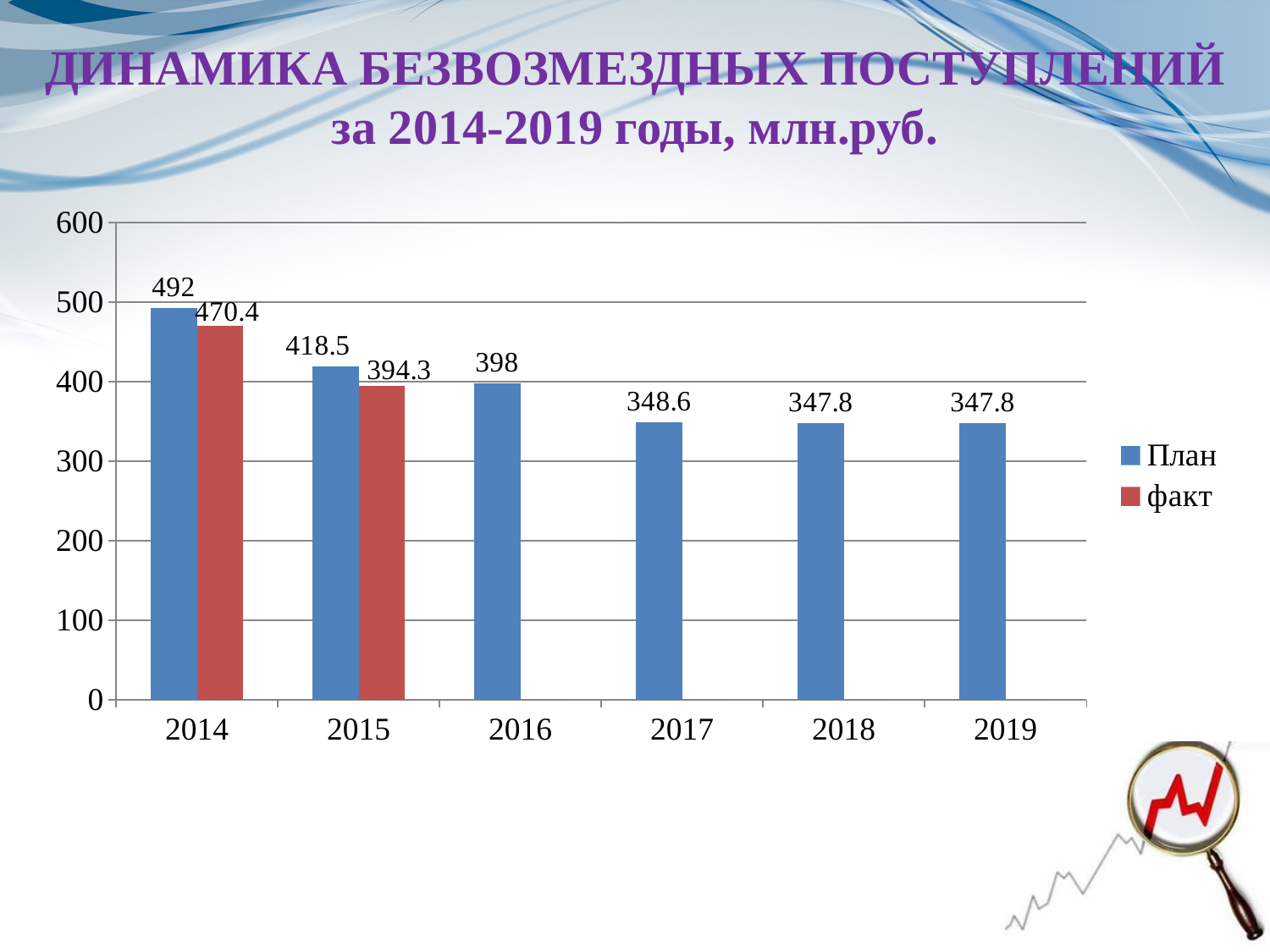
How many series does the legend list? 2 What is the План value for 2017? 348.6 What is the difference between the План and факт values for 2014? 21.6 Which is larger, the План value for 2015 or the факт value for 2015? План What is the План value for 2014? 492 What is the факт value for 2015? 394.3 Which year has the highest План value? 2014 Is the План value for 2016 greater or less than 400? less What kind of chart is shown on the slide? bar chart Do the План values rise or fall from 2014 to 2017? fall How many years are shown on the x axis? 6 What is the difference between the План values for 2015 and 2016? 20.5